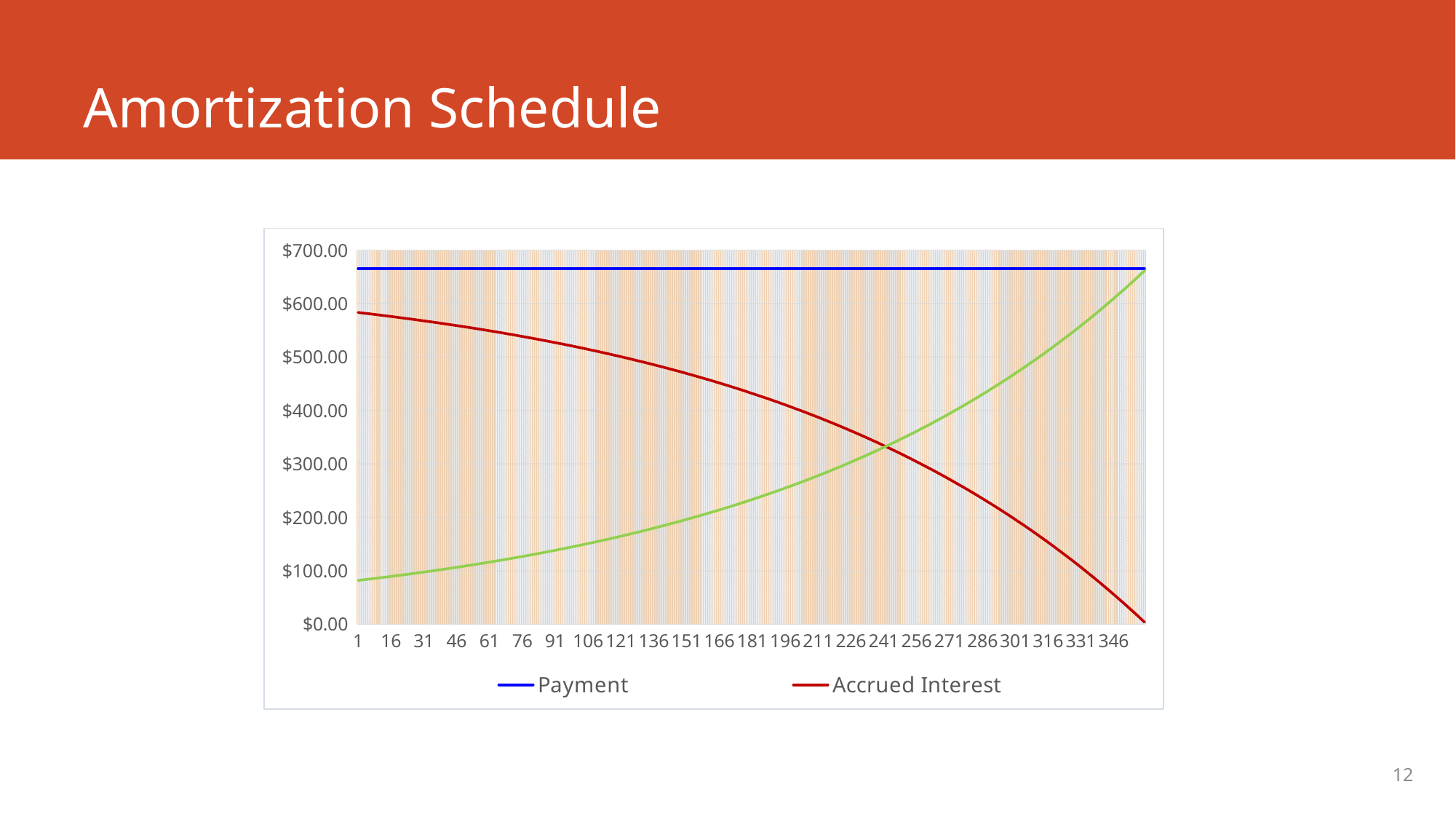
Which two series are named in the chart legend? Payment and Accrued Interest Is the Accrued Interest value at period 1 greater or less than $500.00? greater What kind of chart is shown on the slide? line chart At period 1, which is larger: Payment or Accrued Interest? Payment Is the Payment value greater or less than $700.00? less Is the Accrued Interest value at period 346 greater or less than $100.00? less At period 346, which is larger: Payment or Accrued Interest? Payment Does the Accrued Interest line rise or fall as the x axis increases? fall How many series does the chart legend list? 2 What is the title of the slide containing the chart? Amortization Schedule Does the Payment line rise, fall, or stay flat across the x axis? stay flat